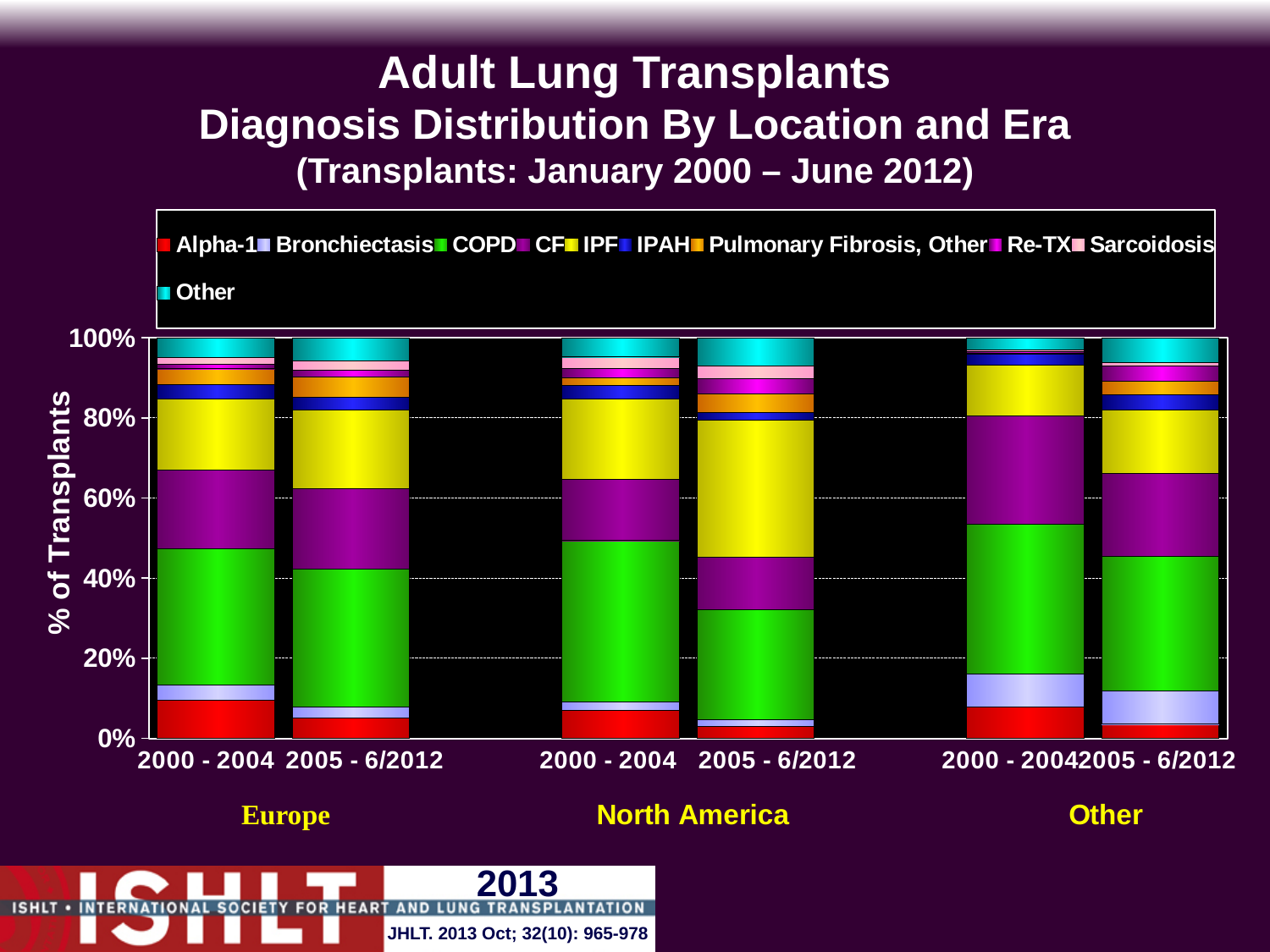
What colour represents COPD in the legend? Green What kind of chart is shown on the slide? Stacked bar chart Is the value at the top of the COPD segment for Other 2000 - 2004 greater or less than 60%? less What is the label of the y axis? % of Transplants How many series does the legend list? 10 Is the value at the top of the COPD segment for Europe 2000 - 2004 greater or less than 40%? greater Is the Alpha-1 share larger for Europe 2000 - 2004 or for North America 2005 - 6/2012? Europe 2000 - 2004 How many location groups are shown along the x axis? 3 How many bars are plotted in the chart? 6 In North America, does the IPF share rise or fall from 2000 - 2004 to 2005 - 6/2012? Rise Is the value at the top of the COPD segment for North America 2005 - 6/2012 greater or less than 40%? less In North America, is the IPF share larger in 2000 - 2004 or in 2005 - 6/2012? 2005 - 6/2012